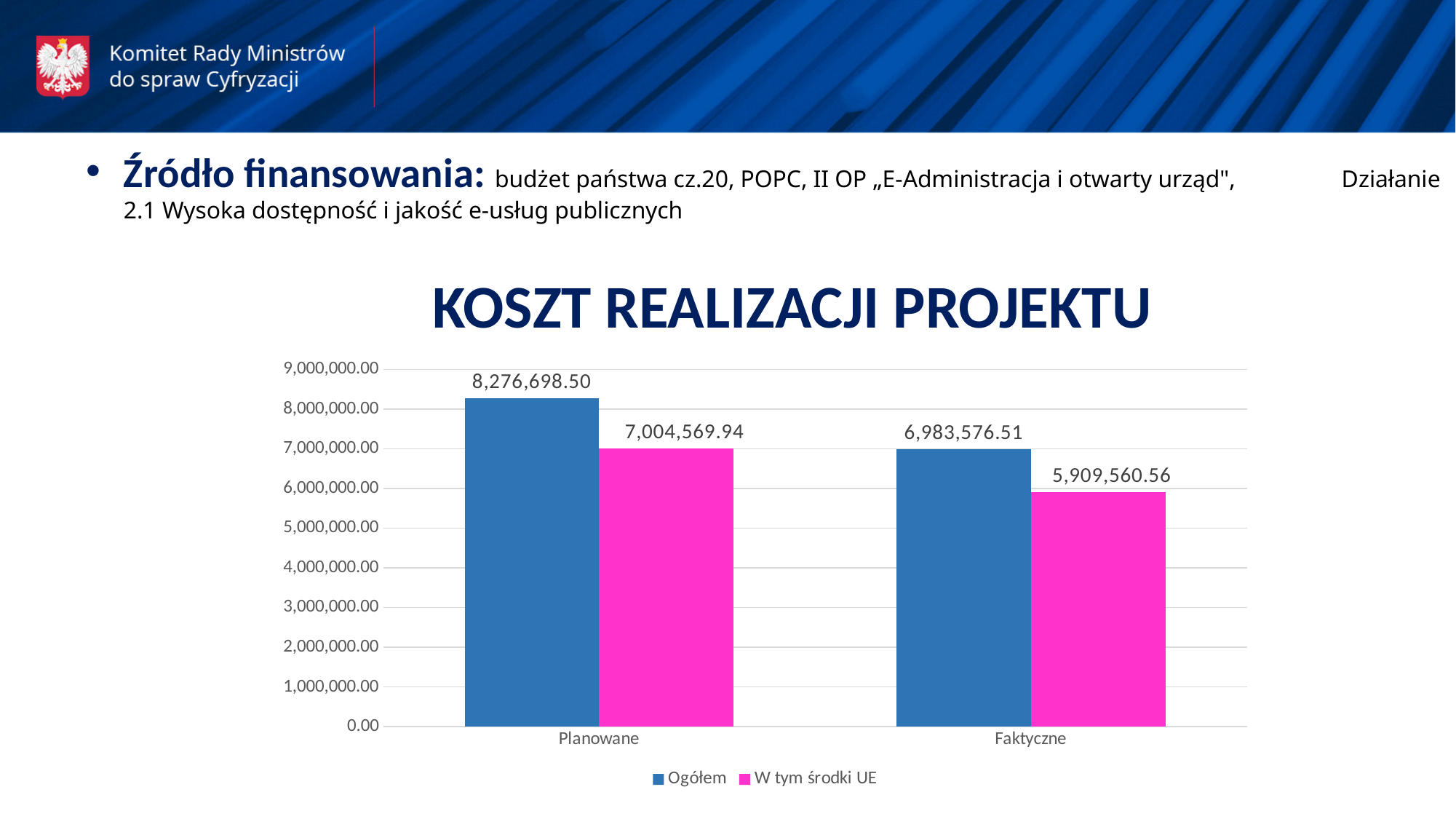
Which bar has the lowest value in the chart? W tym środki UE for Faktyczne What kind of chart is shown on the slide? Bar chart What is the difference between Ogółem and W tym środki UE for Planowane? 1,272,128.56 What is the value of Ogółem for Faktyczne? 6,983,576.51 What is the title of the chart? KOSZT REALIZACJI PROJEKTU Which bar has the highest value in the chart? Ogółem for Planowane What is the value of W tym środki UE for Faktyczne? 5,909,560.56 How many series does the legend list? 2 What is the difference between Ogółem for Planowane and Ogółem for Faktyczne? 1,293,121.99 What is the value of Ogółem for Planowane? 8,276,698.50 Which is larger: W tym środki UE for Planowane or W tym środki UE for Faktyczne? W tym środki UE for Planowane What is the value of W tym środki UE for Planowane? 7,004,569.94